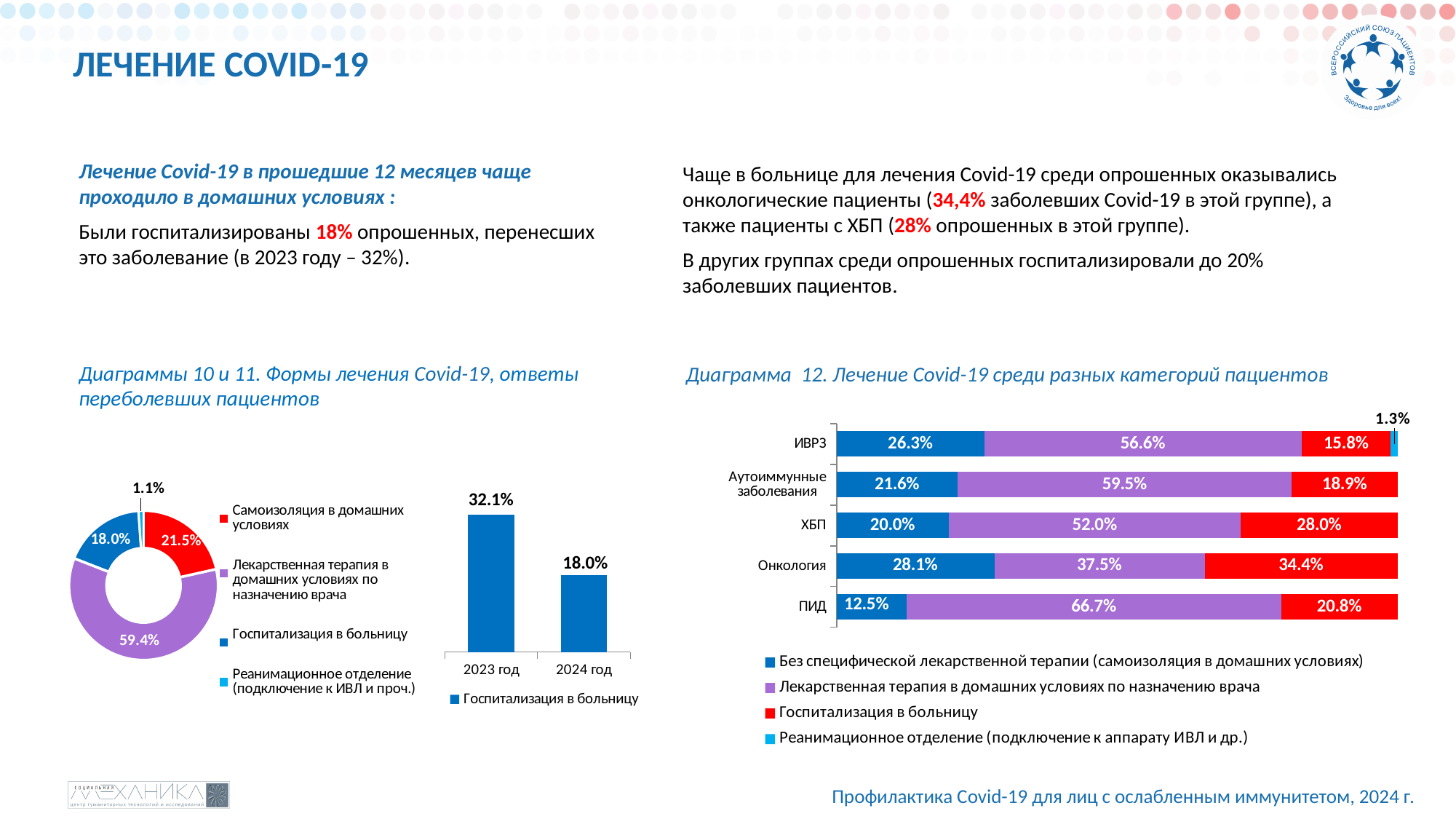
In the donut chart (Diagram 10) on the left, what is the value for 'Реанимационное отделение (подключение к ИВЛ и проч.)'? 1.1% In Diagram 12 (Лечение Covid-19 среди разных категорий пациентов), which patient category has the highest 'Госпитализация в больницу' value? Онкология In the bar chart 'Госпитализация в больницу' in the middle of the slide, do the values rise or fall from 2023 год to 2024 год? fall In the bar chart 'Госпитализация в больницу' in the middle of the slide, what is the difference between the 2023 год and 2024 год values? 14.1% In Diagram 12 (Лечение Covid-19 среди разных категорий пациентов), how many series does the legend list? 4 In Diagram 12 (Лечение Covid-19 среди разных категорий пациентов), how many patient categories are shown? 5 In the bar chart 'Госпитализация в больницу' in the middle of the slide, what is the value for 2023 год? 32.1% In Diagram 12 (Лечение Covid-19 среди разных категорий пациентов), which patient category has the lowest value for 'Без специфической лекарственной терапии (самоизоляция в домашних условиях)'? ПИД In Diagram 12 (Лечение Covid-19 среди разных категорий пациентов), what is the 'Госпитализация в больницу' value for Онкология? 34.4% In Diagram 12 (Лечение Covid-19 среди разных категорий пациентов), which has the larger 'Госпитализация в больницу' value: ХБП or Аутоиммунные заболевания? ХБП In the donut chart (Diagram 10) on the left, what share of respondents chose 'Лекарственная терапия в домашних условиях по назначению врача'? 59.4% What kind of chart is the middle chart showing 'Госпитализация в больницу' by year? bar chart